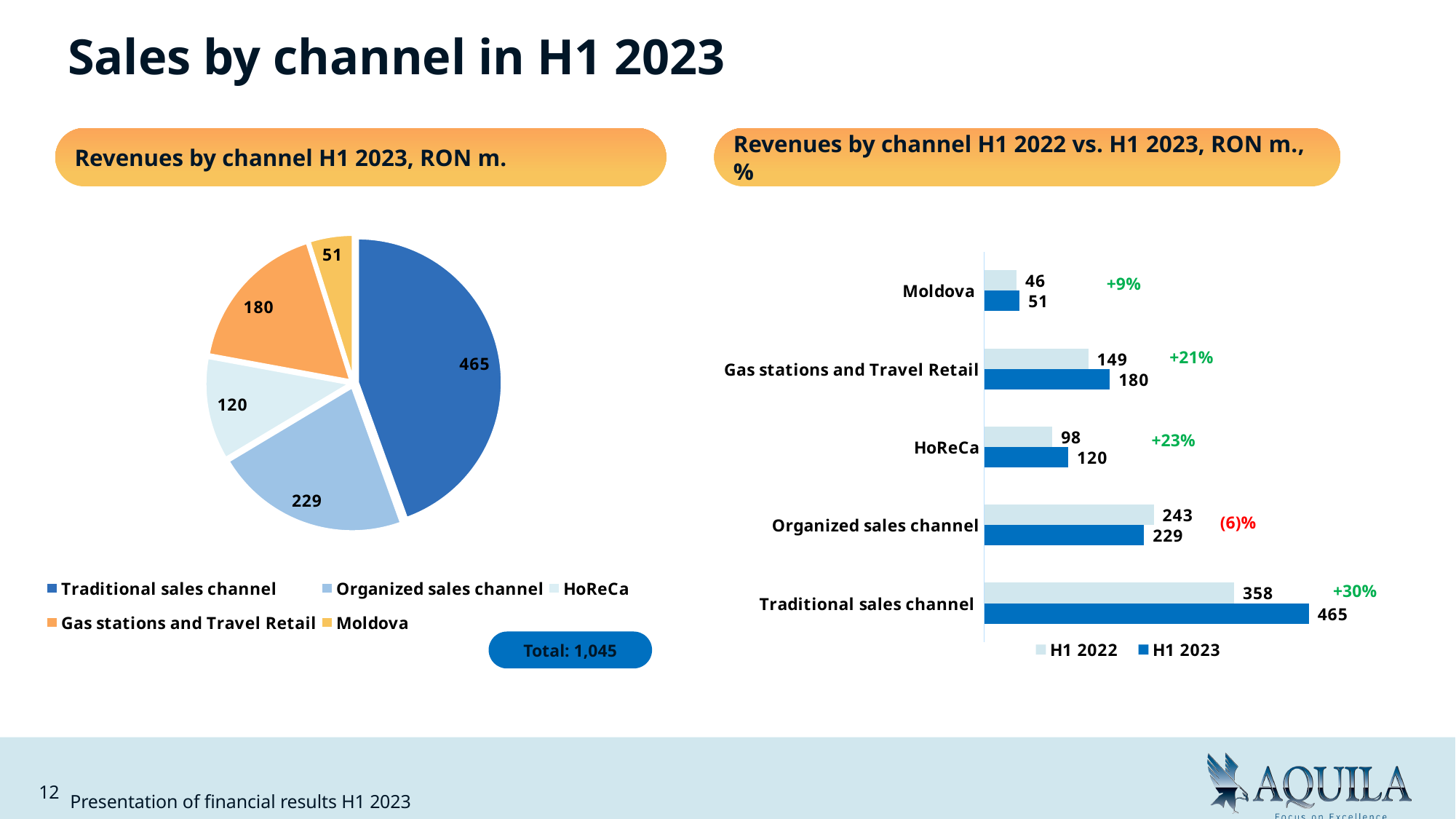
In the bar chart 'Revenues by channel H1 2022 vs. H1 2023', which is larger for Organized sales channel: the H1 2022 value or the H1 2023 value? H1 2022 What type of chart is the chart on the right side of the slide? Bar chart In the pie chart 'Revenues by channel H1 2023, RON m.', what total is shown for all channels? 1,045 In the bar chart 'Revenues by channel H1 2022 vs. H1 2023', what percentage change is shown for HoReCa? +23% In the pie chart 'Revenues by channel H1 2023, RON m.', how many channels are shown? 5 In the pie chart 'Revenues by channel H1 2023, RON m.', which channel has the largest slice? Traditional sales channel In the bar chart 'Revenues by channel H1 2022 vs. H1 2023', what is the H1 2022 value for Gas stations and Travel Retail? 149 In the bar chart 'Revenues by channel H1 2022 vs. H1 2023', which channel shows a negative percentage change? Organized sales channel In the bar chart 'Revenues by channel H1 2022 vs. H1 2023', what is the difference between the H1 2023 and H1 2022 values for Traditional sales channel? 107 In the pie chart 'Revenues by channel H1 2023, RON m.', what is the value for Organized sales channel? 229 In the bar chart 'Revenues by channel H1 2022 vs. H1 2023', how many series does the legend list? 2 In the pie chart 'Revenues by channel H1 2023, RON m.', which channel has the smallest slice? Moldova